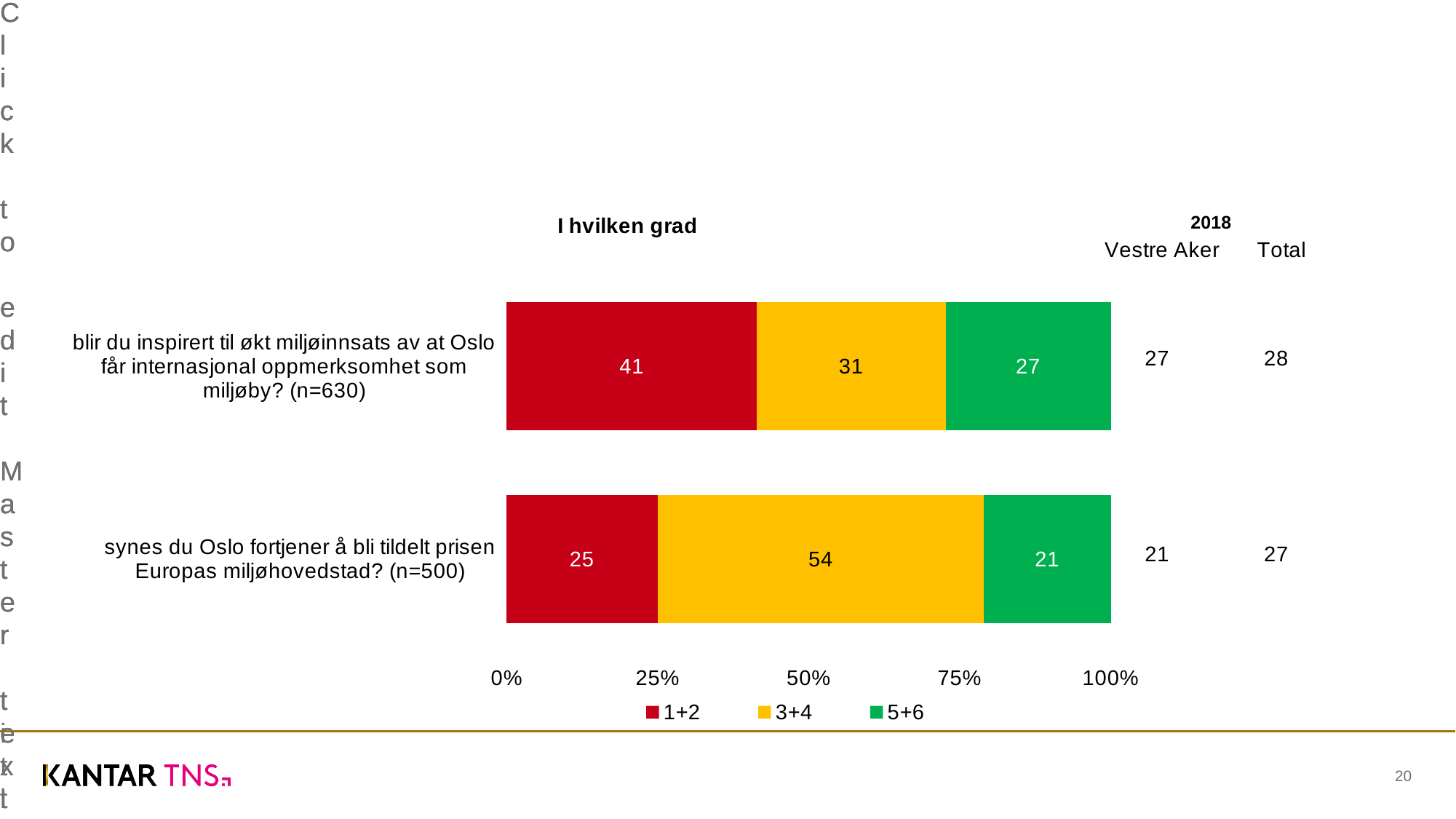
How many series does the legend list? 3 What is the value of the 1+2 series for the category "blir du inspirert til økt miljøinnsats av at Oslo får internasjonal oppmerksomhet som miljøby? (n=630)"? 41 Which category has the higher value for the 3+4 series? synes du Oslo fortjener å bli tildelt prisen Europas miljøhovedstad? (n=500) What is the total of the stacked bar for "synes du Oslo fortjener å bli tildelt prisen Europas miljøhovedstad? (n=500)"? 100 Is the 1+2 value larger for "blir du inspirert til økt miljøinnsats..." or for "synes du Oslo fortjener å bli tildelt prisen..."? blir du inspirert til økt miljøinnsats av at Oslo får internasjonal oppmerksomhet som miljøby? (n=630) How many categories are shown in the chart? 2 What is the value of the 5+6 series for the category "blir du inspirert til økt miljøinnsats av at Oslo får internasjonal oppmerksomhet som miljøby? (n=630)"? 27 Which category has the lower value for the 5+6 series? synes du Oslo fortjener å bli tildelt prisen Europas miljøhovedstad? (n=500) What is the difference between the 1+2 values of the two categories? 16 What is the value of the 1+2 series for the category "synes du Oslo fortjener å bli tildelt prisen Europas miljøhovedstad? (n=500)"? 25 What is the value of the 3+4 series for the category "synes du Oslo fortjener å bli tildelt prisen Europas miljøhovedstad? (n=500)"? 54 What kind of chart is shown on the slide? Stacked bar chart